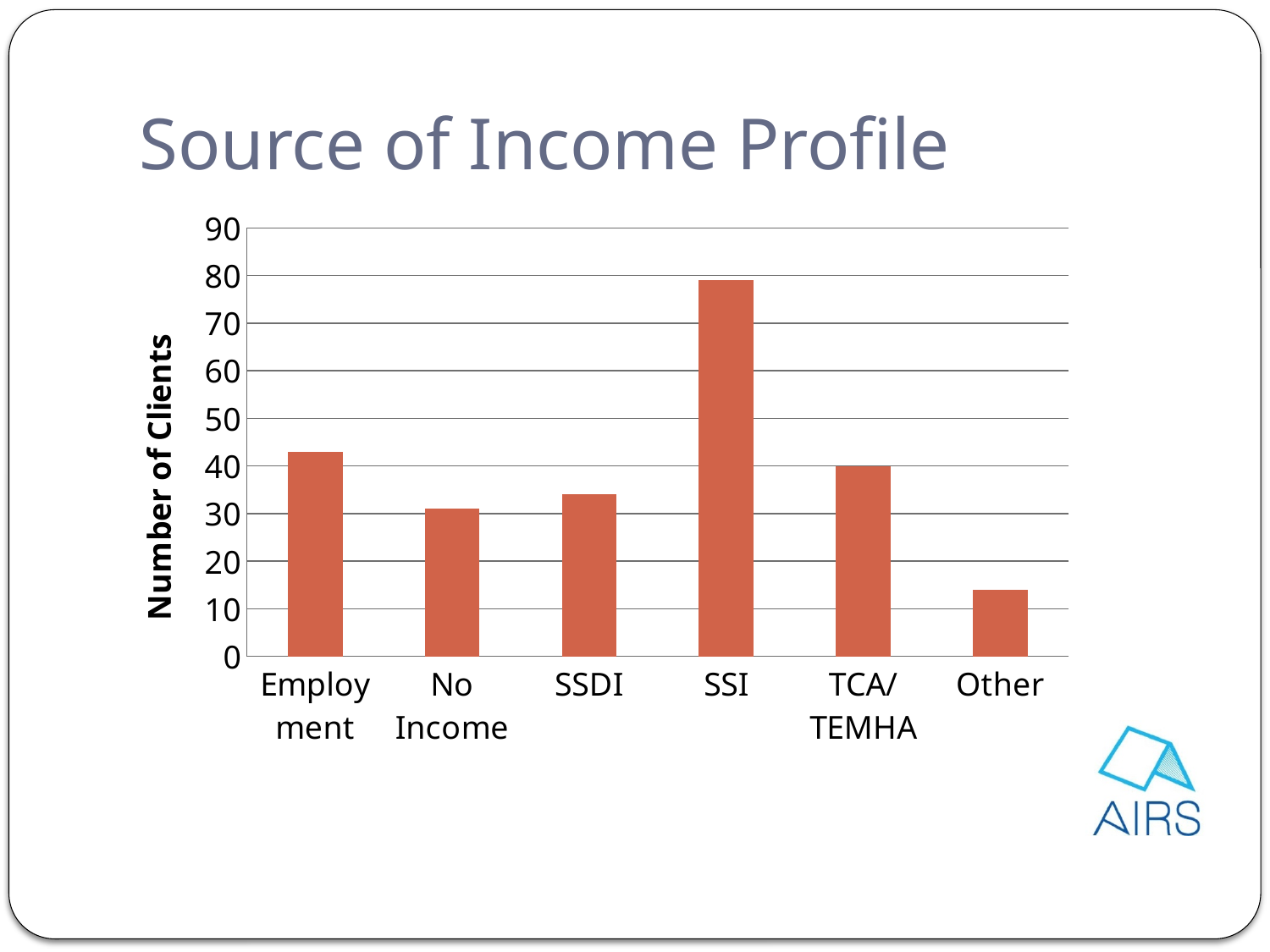
Is the number of clients for Other greater or less than 20? less Is the number of clients for Employment greater or less than 50? less Which has more clients, Employment or No Income? Employment How many income source categories are shown on the x axis? 6 Which has more clients, SSI or TCA/TEMHA? SSI What kind of chart is shown on the slide? Bar chart What is the number of clients for TCA/TEMHA? 40 Is the number of clients for SSI greater or less than 70? greater What is the title of the chart? Source of Income Profile Which income source has the lowest number of clients? Other Which income source has the highest number of clients? SSI What is the label on the vertical axis? Number of Clients